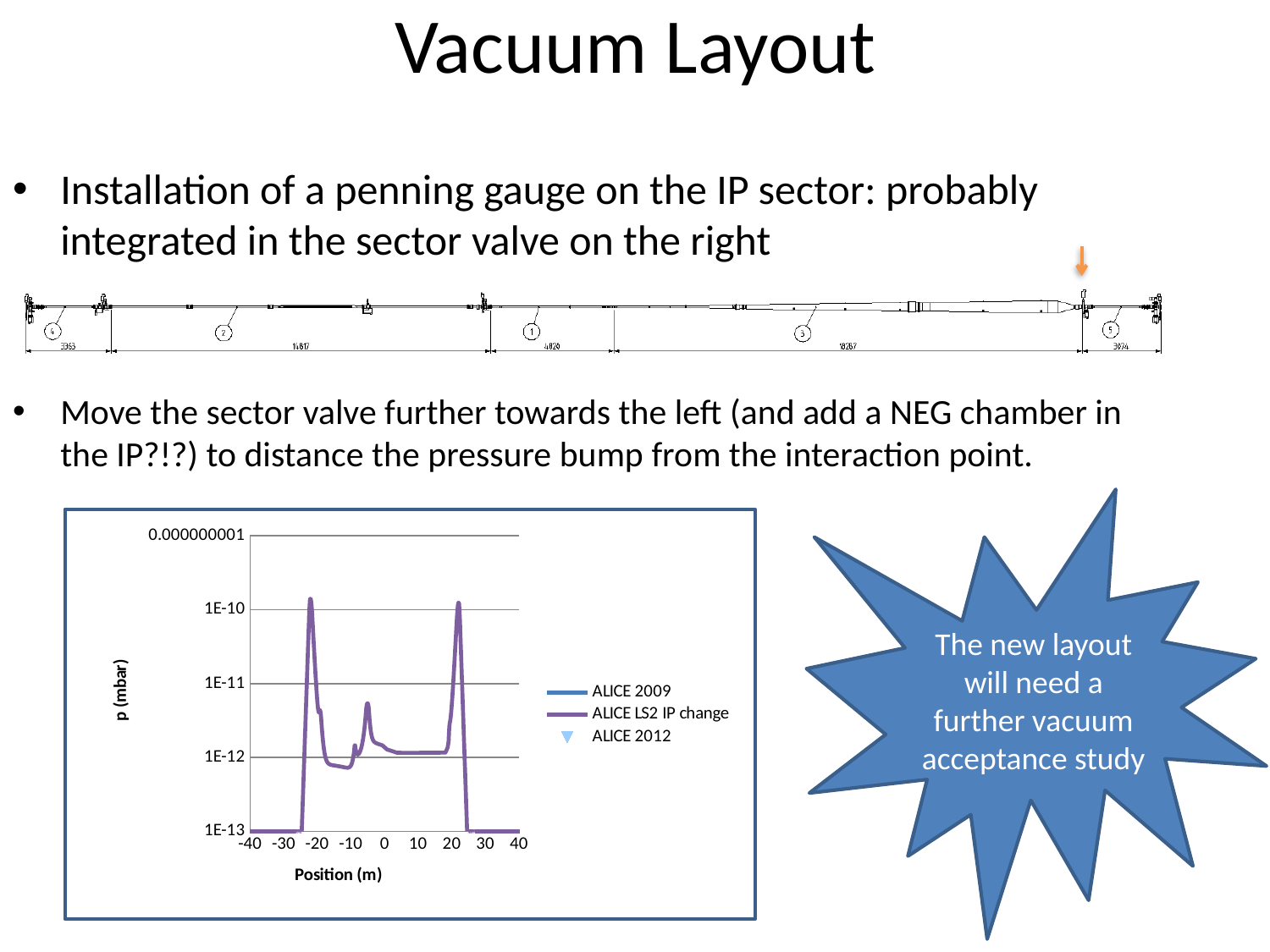
Is the pressure value at position 30 m greater or less than 1E-12? less How many series does the chart legend list? 3 What is the label of the y axis of the chart? p (mbar) Is the peak pressure value near position 20 m greater or less than 1E-12? greater Is the pressure value at position -35 m greater or less than 1E-12? less What is the label of the x axis of the chart? Position (m) How many tick labels are shown on the x axis of the chart? 9 What kind of chart is shown on the slide? line chart What is the lowest tick label shown on the y axis of the chart? 1E-13